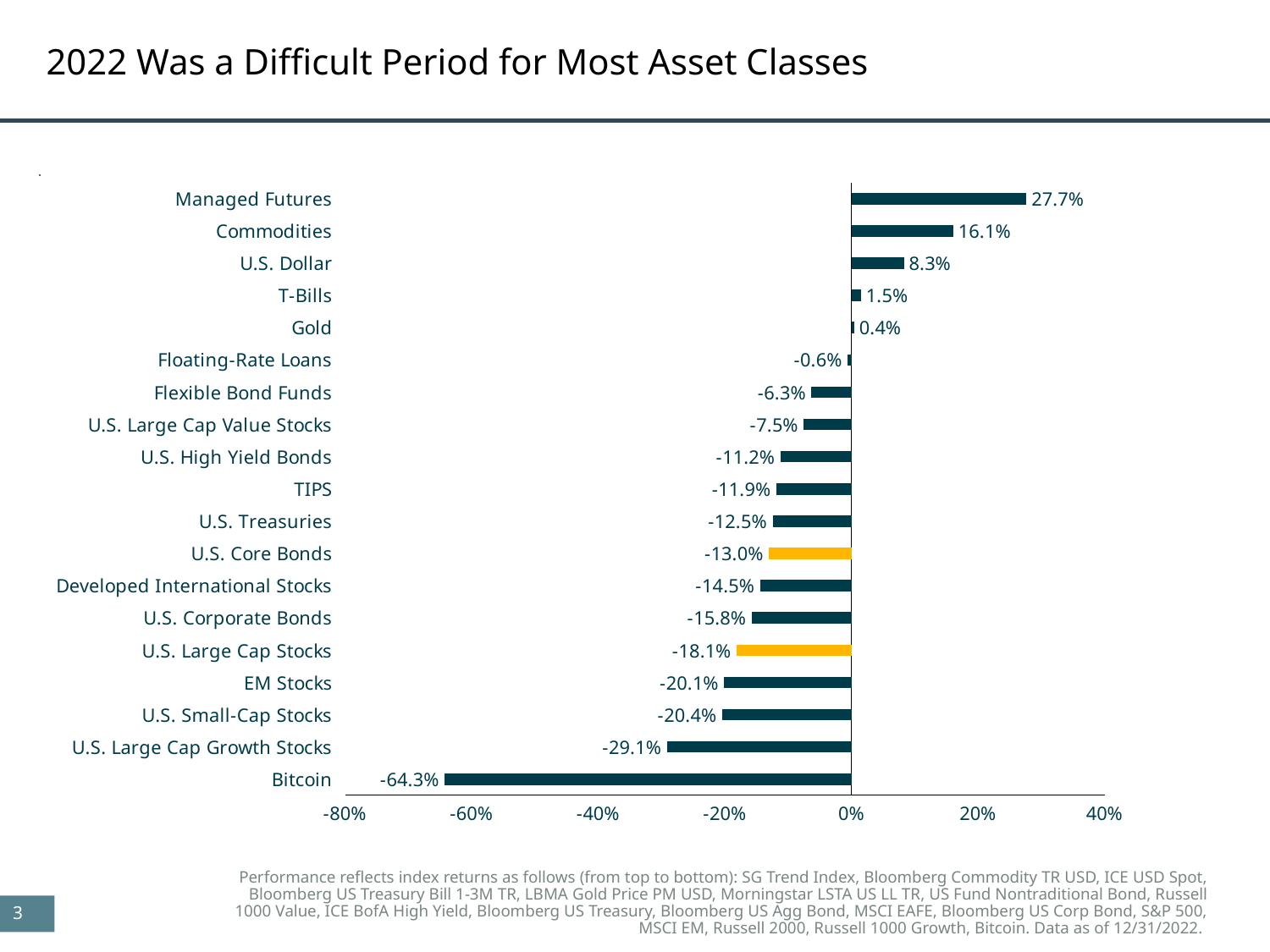
Which asset class had the lowest return? Bitcoin What was the return for U.S. Core Bonds? -13.0% Which two asset classes are highlighted with yellow bars? U.S. Core Bonds and U.S. Large Cap Stocks What was the return for Managed Futures? 27.7% Which asset class had the highest return? Managed Futures What is the difference between the returns of Commodities and the U.S. Dollar? 7.8% How many asset classes are shown in the chart? 19 How many asset classes had a positive return? 5 Which had a higher return, U.S. Large Cap Stocks or U.S. Small-Cap Stocks? U.S. Large Cap Stocks What was the return for Bitcoin? -64.3% What type of chart is shown on the slide? Bar chart Is the value for U.S. Large Cap Growth Stocks greater or less than -20%? less